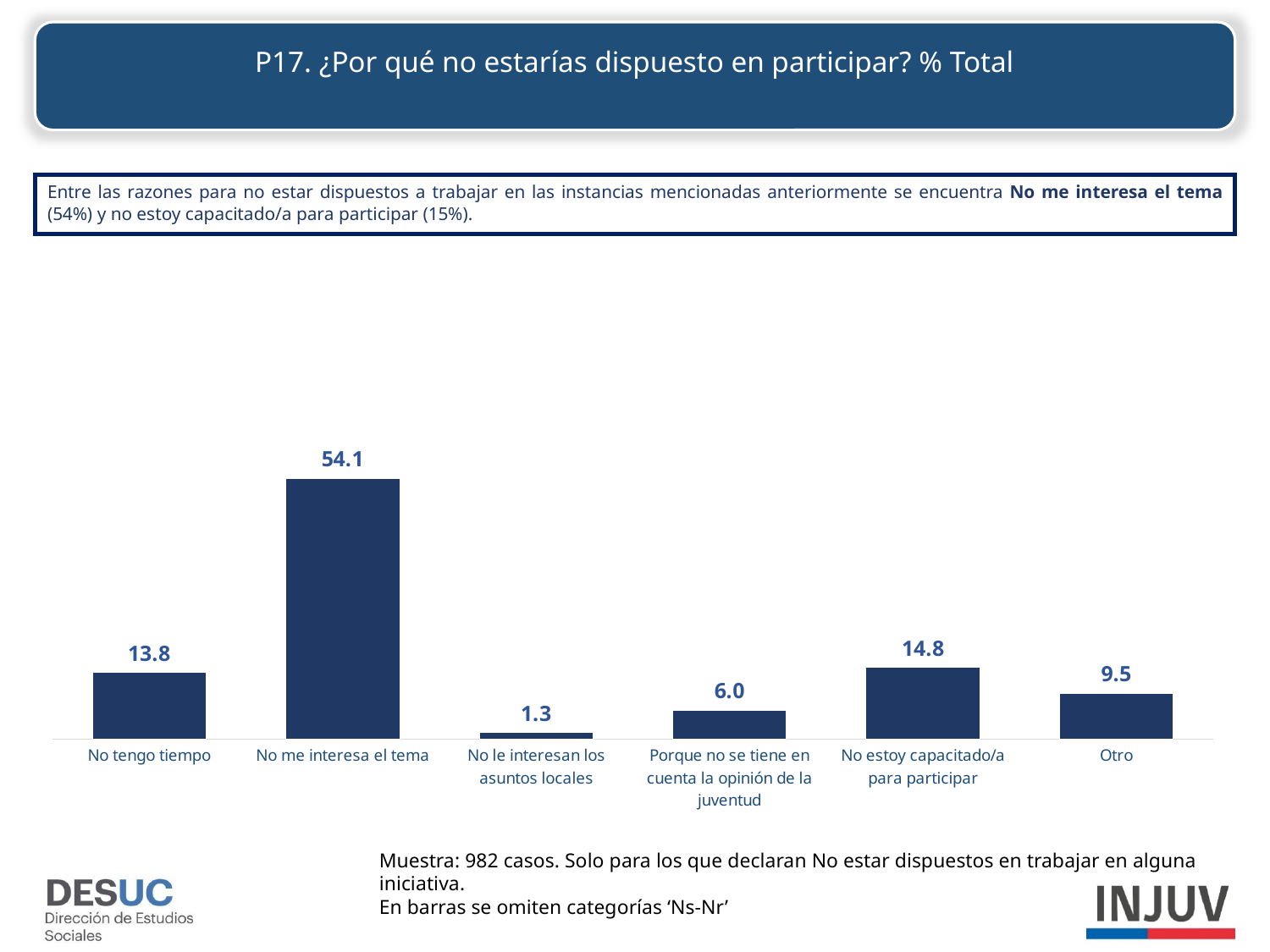
What is the difference between 'No me interesa el tema' and 'Otro'? 44.6 What kind of chart is shown on the slide? Bar chart What is the value for 'Porque no se tiene en cuenta la opinión de la juventud'? 6.0 What is the title of the chart on the slide? P17. ¿Por qué no estarías dispuesto en participar? % Total Which category has the highest value? No me interesa el tema What is the value for 'Otro'? 9.5 How many categories are shown in the chart? 6 What is the value for 'No me interesa el tema'? 54.1 Which category has the lowest value? No le interesan los asuntos locales Which is larger, the value for 'No estoy capacitado/a para participar' or the value for 'Otro'? No estoy capacitado/a para participar What is the value for 'No tengo tiempo'? 13.8 What is the difference between 'No estoy capacitado/a para participar' and 'No tengo tiempo'? 1.0